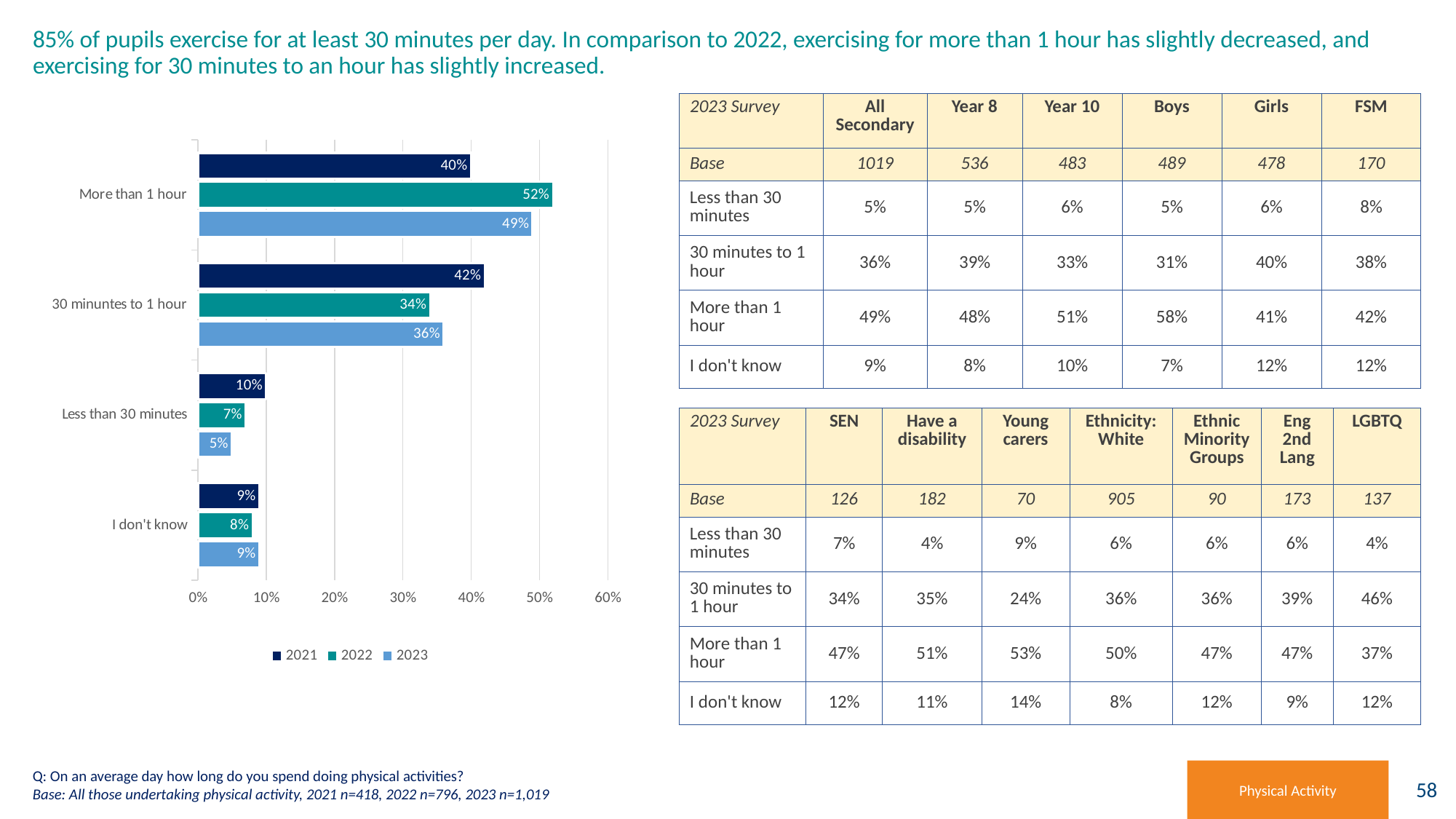
Which is larger for '30 minuntes to 1 hour': the 2021 value or the 2023 value? 2021 What is the 2023 value for 'I don't know'? 9% Which category has the lowest 2023 value? Less than 30 minutes What is the difference between the 2022 and 2023 values for 'More than 1 hour'? 3% What is the 2023 value for 'More than 1 hour'? 49% How many categories are shown on the chart? 4 What is the 2022 value for '30 minuntes to 1 hour'? 34% Which category has the highest 2022 value? More than 1 hour How many series does the chart legend list? 3 What kind of chart is shown on the slide? bar chart Which series is shown in the darkest blue colour in the chart? 2021 What is the 2021 value for 'Less than 30 minutes'? 10%